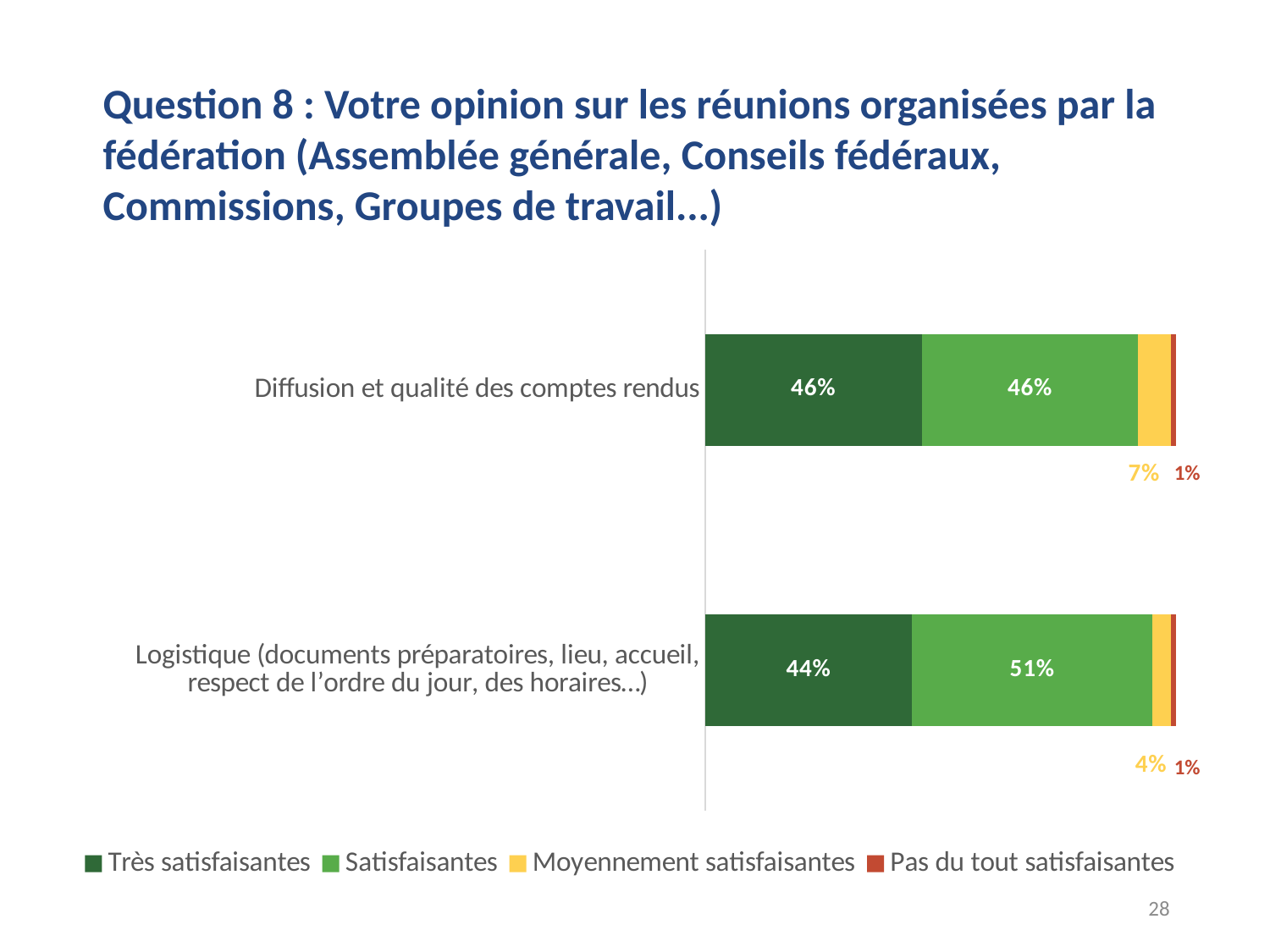
What is the difference between the 'Moyennement satisfaisantes' values for 'Diffusion et qualité des comptes rendus' and 'Logistique'? 3% What is the difference between the 'Satisfaisantes' and 'Très satisfaisantes' values for 'Logistique'? 7% What type of chart is shown on the slide? Stacked bar chart How many series does the legend list? 4 What percentage of respondents rated 'Diffusion et qualité des comptes rendus' as 'Très satisfaisantes'? 46% Which category has the higher 'Satisfaisantes' percentage? Logistique (documents préparatoires, lieu, accueil, respect de l'ordre du jour, des horaires…) How many categories are shown in the chart? 2 What is the 'Moyennement satisfaisantes' value for 'Diffusion et qualité des comptes rendus'? 7% Which colour represents 'Pas du tout satisfaisantes' in the legend? Red What is the 'Pas du tout satisfaisantes' value for 'Logistique (documents préparatoires, lieu, accueil, respect de l'ordre du jour, des horaires…)'? 1% What percentage of respondents rated 'Logistique (documents préparatoires, lieu, accueil, respect de l'ordre du jour, des horaires…)' as 'Satisfaisantes'? 51% What is the total of the stacked bar for 'Diffusion et qualité des comptes rendus'? 100%